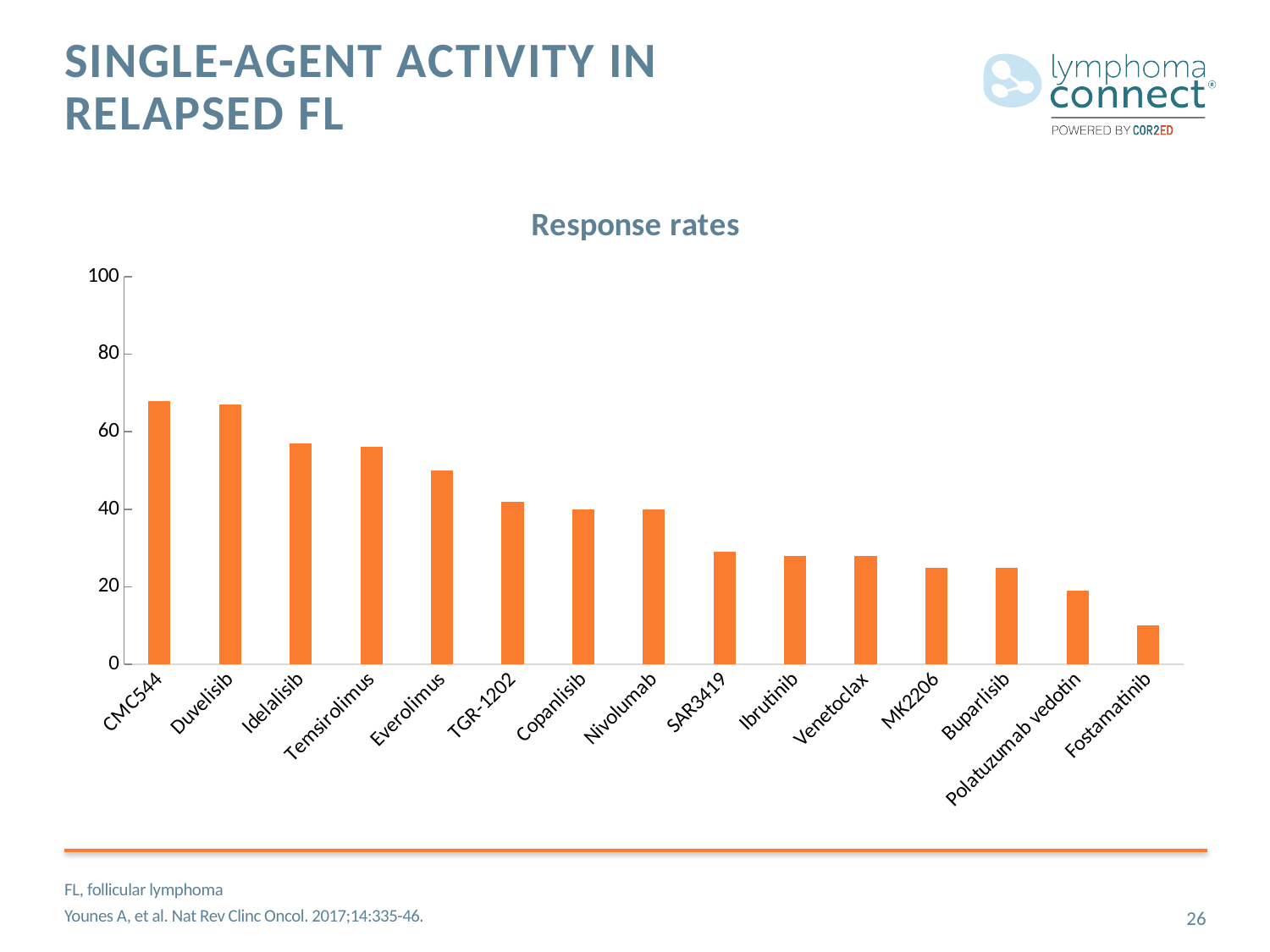
Do the response rates rise or fall moving from left to right along the x axis? Fall Which agent has the lowest response rate in the chart? Fostamatinib Which has the higher response rate, Idelalisib or Copanlisib? Idelalisib Is the value for CMC544 greater or less than 60? greater Which has the higher response rate, Nivolumab or Polatuzumab vedotin? Nivolumab How many agents are plotted on the x axis of the chart? 15 What kind of chart is shown on the slide? Bar chart What is the title of the chart? Response rates Is the value for Idelalisib greater or less than 60? less Is the value for Ibrutinib greater or less than 40? less